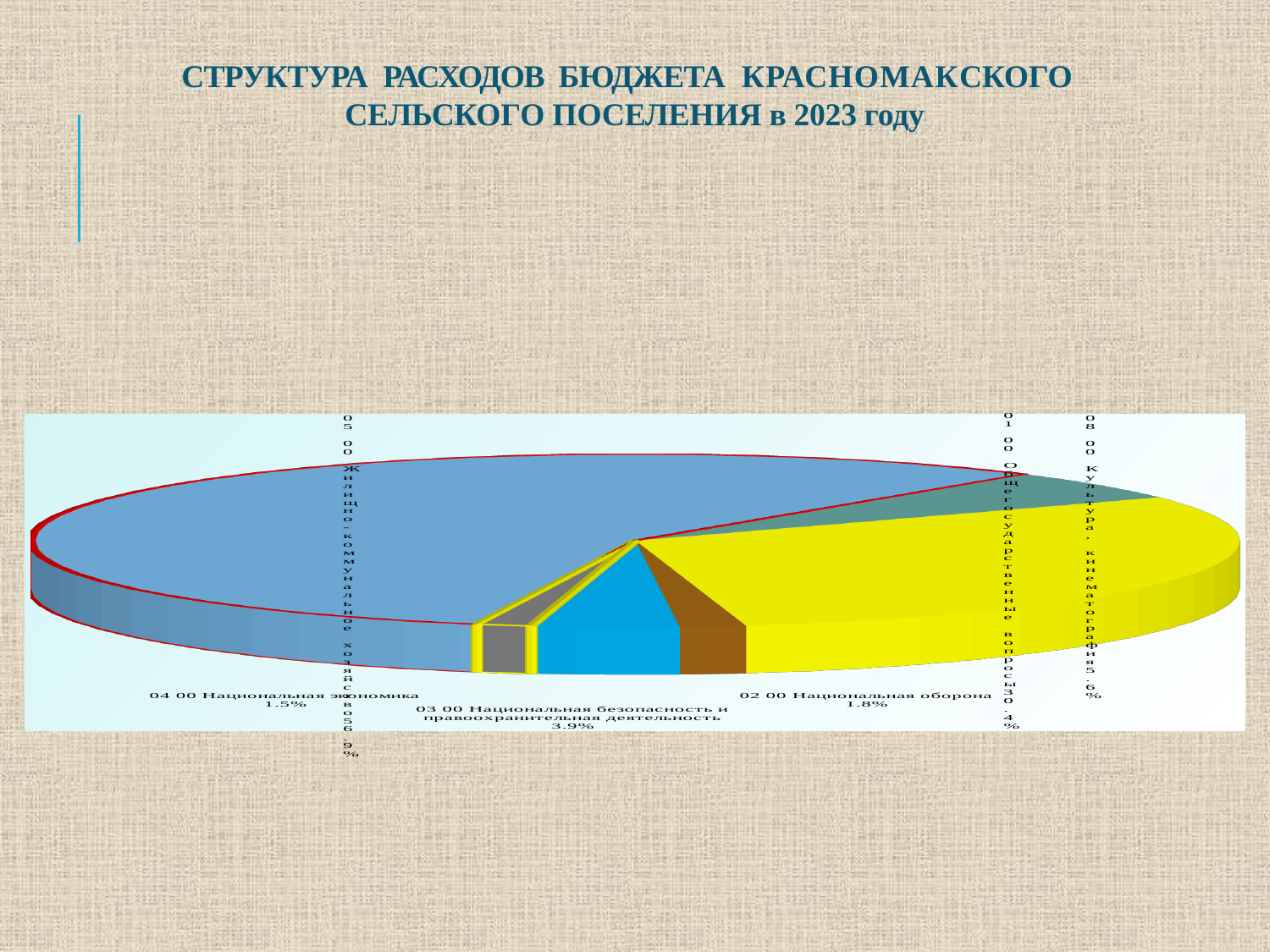
What share is shown for 02 00 Национальная оборона? 1.8% What share is shown for 03 00 Национальная безопасность и правоохранительная деятельность? 3.9% What is the difference in percentage points between 05 00 Жилищно-коммунальное хозяйство and 01 00 Общегосударственные вопросы? 26.5 Which has a larger share: 02 00 Национальная оборона or 04 00 Национальная экономика? 02 00 Национальная оборона Which expenditure category has the largest share of the pie? 05 00 Жилищно-коммунальное хозяйство What kind of chart is shown on the slide? Pie chart What share of the budget expenditure goes to 01 00 Общегосударственные вопросы? 30.4% How many expenditure categories are shown in the pie chart? 6 Which expenditure category has the smallest share of the pie? 04 00 Национальная экономика What share of the budget expenditure goes to 05 00 Жилищно-коммунальное хозяйство? 56.9% What share is shown for 08 00 Культура, кинематография? 5.6% What year does the chart title say the budget expenditure structure refers to? 2023